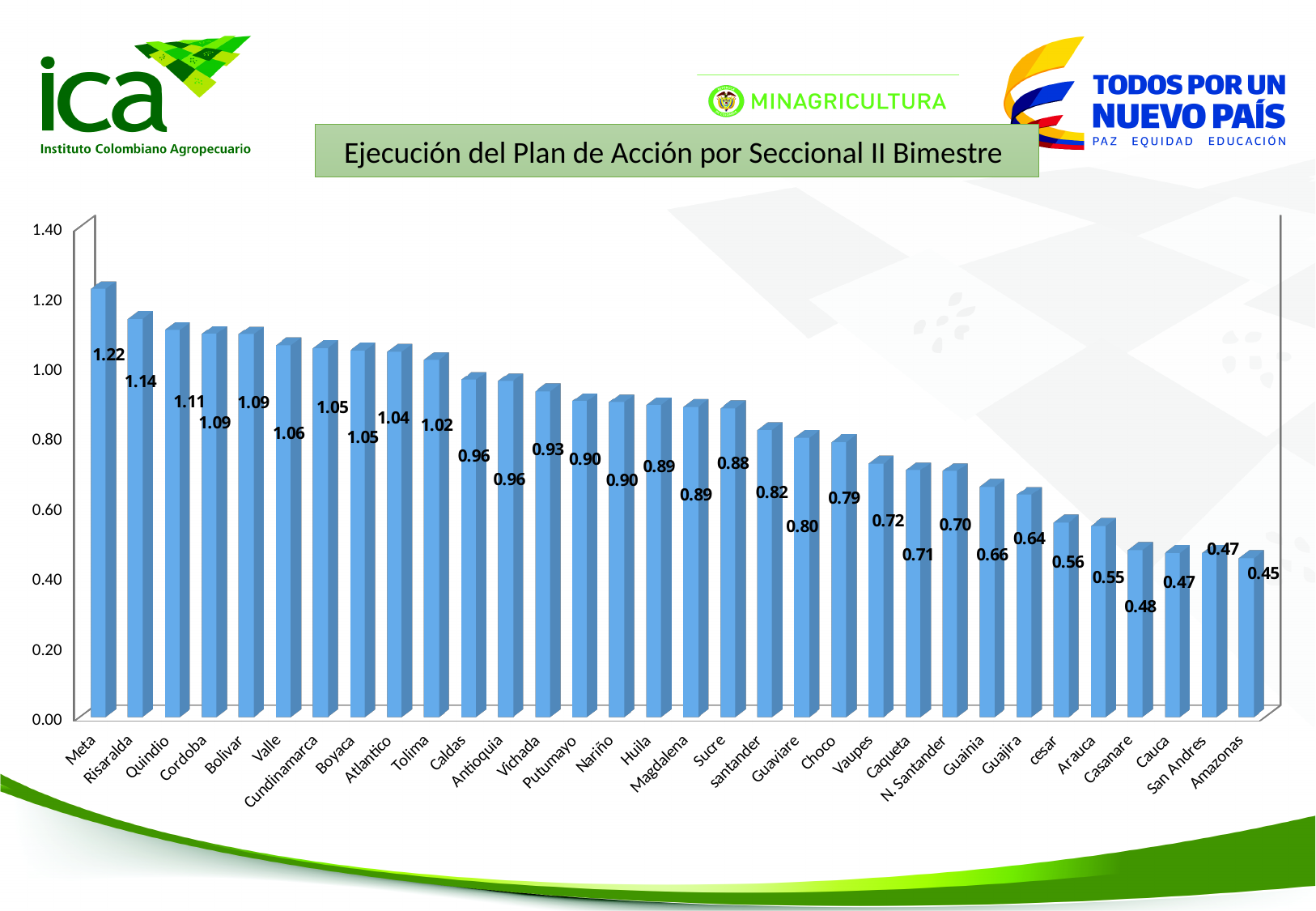
What is the value for Choco? 0.79 Do the values rise or fall from left to right along the x axis? fall What is the value for Tolima? 1.02 Which seccional has the highest value? Meta What is the value for Guajira? 0.64 How many seccionales are shown on the x axis? 32 What is the difference between the values for Risaralda and Sucre? 0.26 Which has a larger value, Vichada or Caqueta? Vichada What is the value for Meta? 1.22 What is the difference between the values for Meta and Amazonas? 0.77 Is the value for Guaviare greater or less than 1.00? less Which seccional has the lowest value? Amazonas